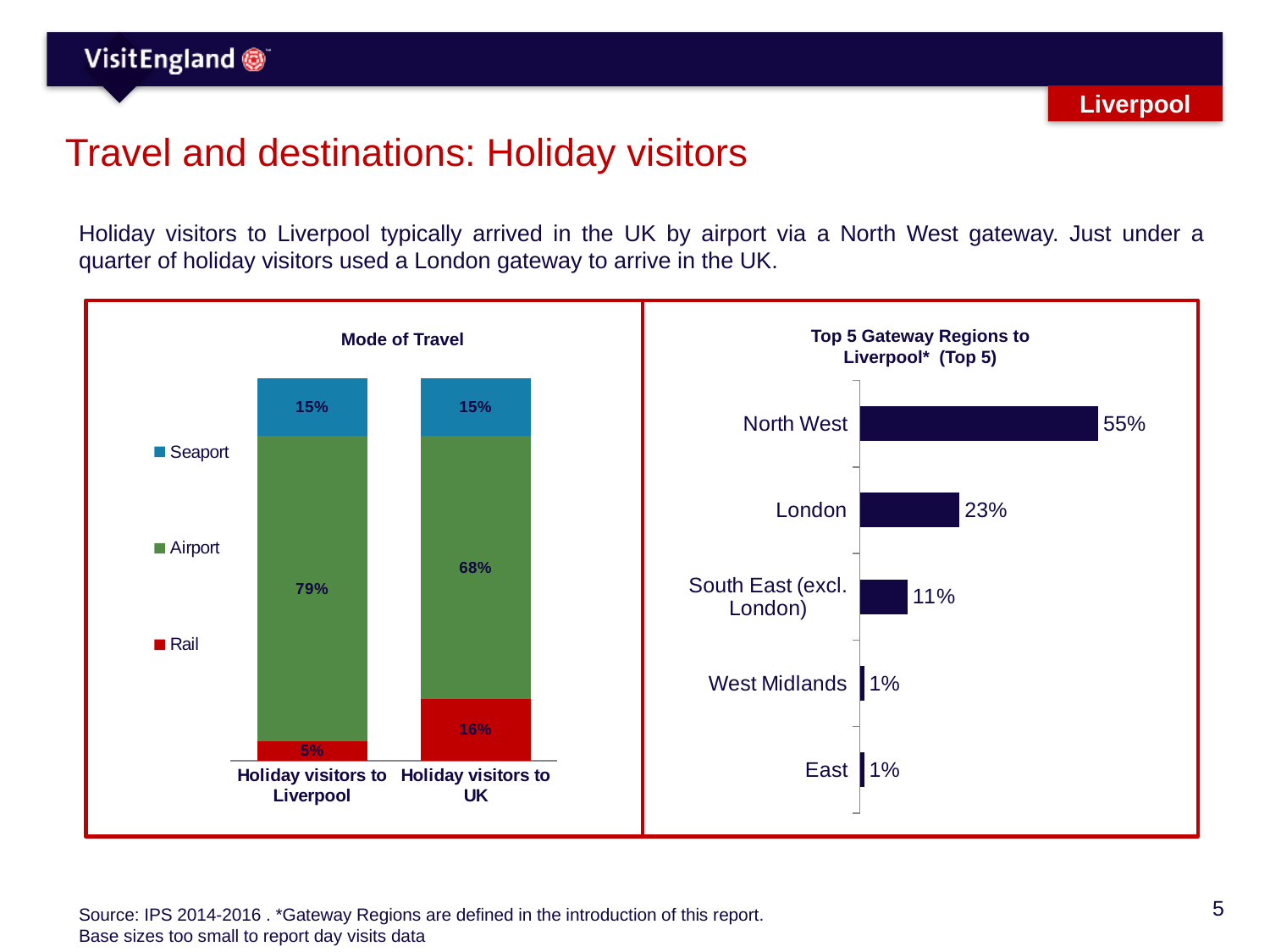
In the 'Mode of Travel' chart, what percentage of holiday visitors to the UK arrived by rail? 16% In the 'Mode of Travel' chart, how many series does the legend list? 3 In the 'Top 5 Gateway Regions to Liverpool' chart, what is the value for London? 23% In the 'Mode of Travel' chart, which colour represents Seaport in the legend? Blue In the 'Top 5 Gateway Regions to Liverpool' chart, what is the difference between North West and London? 32 percentage points In the 'Mode of Travel' chart, what percentage of holiday visitors to Liverpool arrived by airport? 79% What kind of chart is the 'Top 5 Gateway Regions to Liverpool' chart? Bar chart In the 'Top 5 Gateway Regions to Liverpool' chart, which region has the highest value? North West In the 'Mode of Travel' chart, what is the difference between the airport share for holiday visitors to Liverpool and for holiday visitors to the UK? 11 percentage points In the 'Mode of Travel' chart, which is larger: the rail share for holiday visitors to Liverpool or for holiday visitors to the UK? Holiday visitors to UK In the 'Mode of Travel' chart, what is the total of the stacked bar for holiday visitors to Liverpool? 99% In the 'Top 5 Gateway Regions to Liverpool' chart, how many regions are shown? 5